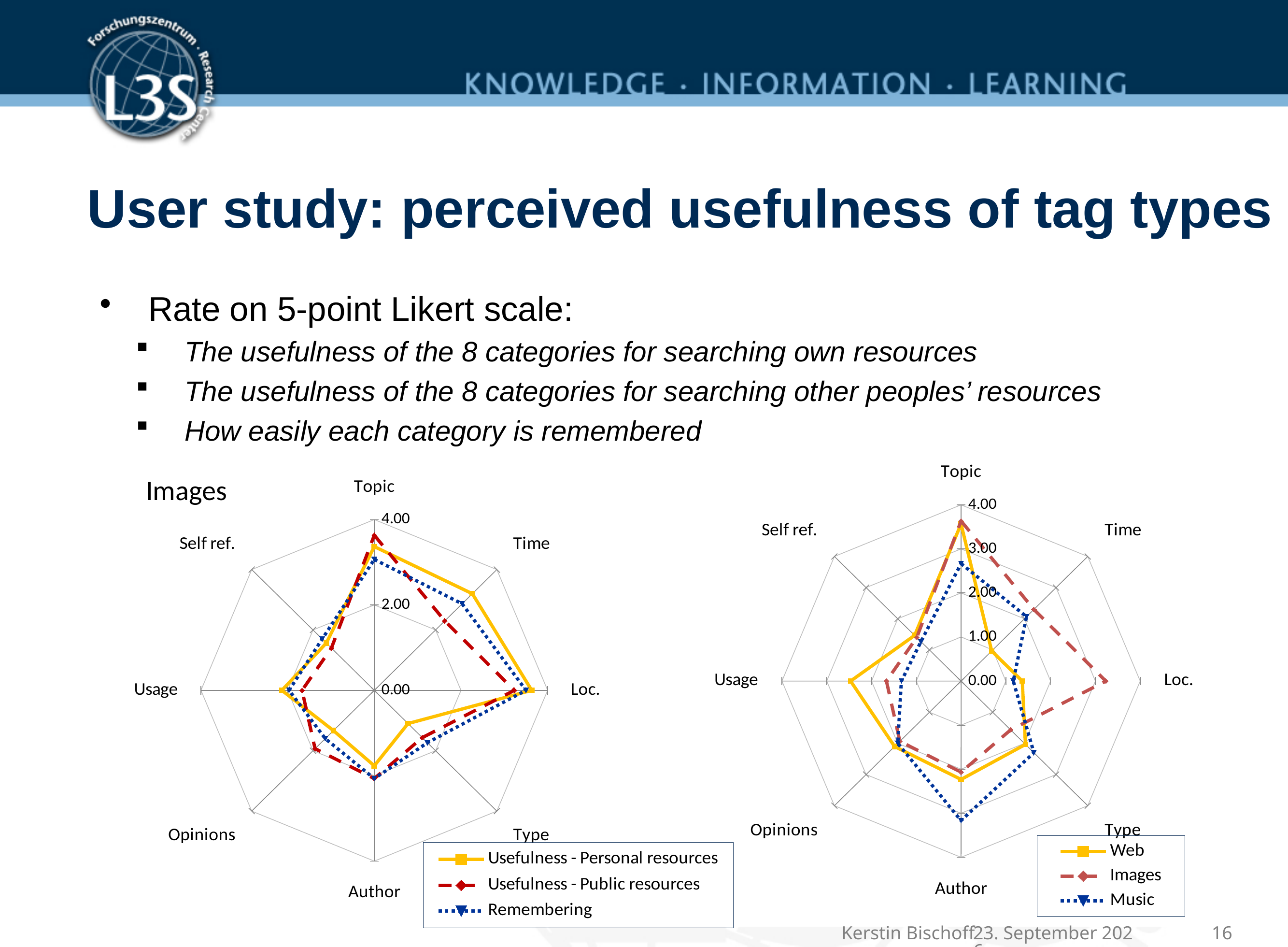
In the left "Images" chart, is the value of Usefulness - Personal resources for Loc. greater or less than 2.00? greater In the right chart, which is larger for Author: Music or Web? Music In the left "Images" chart, which series does the dotted blue line represent? Remembering In the right chart, which series has the highest value for Loc.? Images In the right chart, which series does the dashed red line represent? Images What kind of chart is the left chart titled "Images"? radar chart In the right chart, is the value of Images for Loc. greater or less than 3.00? greater How many categories (axes) does the left "Images" radar chart have? 8 In the left "Images" chart, is the value of Usefulness - Personal resources for Type greater or less than 2.00? less In the left "Images" chart, which is larger for Time: Usefulness - Personal resources or Usefulness - Public resources? Usefulness - Personal resources How many series does the legend of the right radar chart list? 3